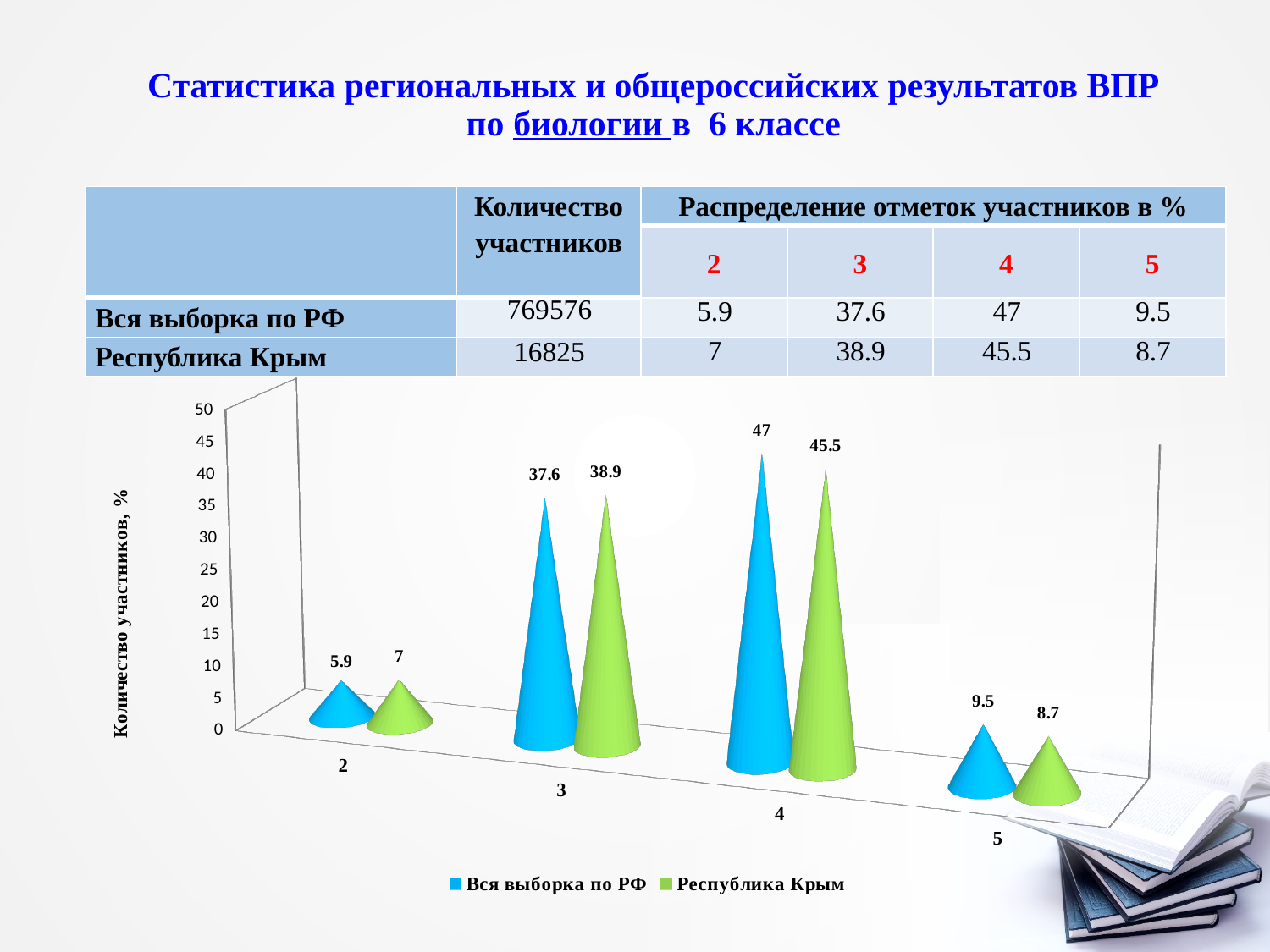
What is the label of the vertical axis of the chart? Количество участников, % Which is larger at category 5: "Вся выборка по РФ" or "Республика Крым"? Вся выборка по РФ How many series does the chart legend list? 2 What kind of chart is shown on the slide? bar chart What is the value for "Республика Крым" at category 3? 38.9 How many categories are shown on the x axis of the chart? 4 Which category has the lowest value for "Республика Крым"? 2 What is the value for "Вся выборка по РФ" at category 4? 47 What is the difference between "Вся выборка по РФ" and "Республика Крым" at category 4? 1.5 Which category has the highest value for "Вся выборка по РФ"? 4 What is the value for "Республика Крым" at category 5? 8.7 Which is larger at category 2: "Вся выборка по РФ" or "Республика Крым"? Республика Крым